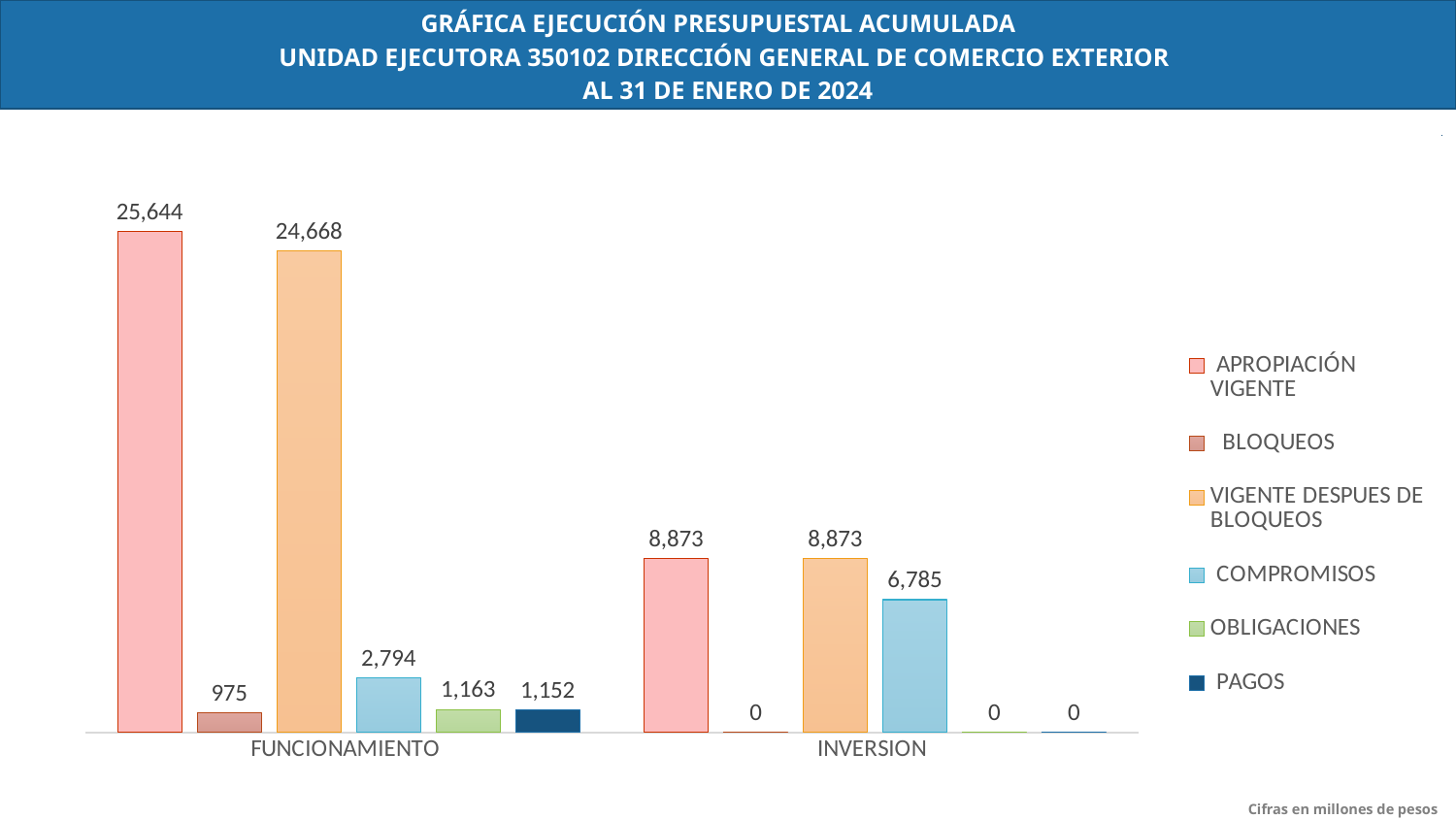
What kind of chart is shown on the slide? Bar chart What is the value of COMPROMISOS for INVERSION? 6,785 Which series has the highest value for FUNCIONAMIENTO? APROPIACIÓN VIGENTE What is the difference between VIGENTE DESPUES DE BLOQUEOS and COMPROMISOS for INVERSION? 2,088 What is the value of APROPIACIÓN VIGENTE for FUNCIONAMIENTO? 25,644 Which is larger: OBLIGACIONES for FUNCIONAMIENTO or PAGOS for FUNCIONAMIENTO? OBLIGACIONES for FUNCIONAMIENTO What is the value of PAGOS for INVERSION? 0 How many categories are shown on the x axis? 2 What is the value of BLOQUEOS for FUNCIONAMIENTO? 975 What unit are the figures in, according to the note on the slide? Millones de pesos How many series does the legend list? 6 What is the difference between APROPIACIÓN VIGENTE and VIGENTE DESPUES DE BLOQUEOS for FUNCIONAMIENTO? 976